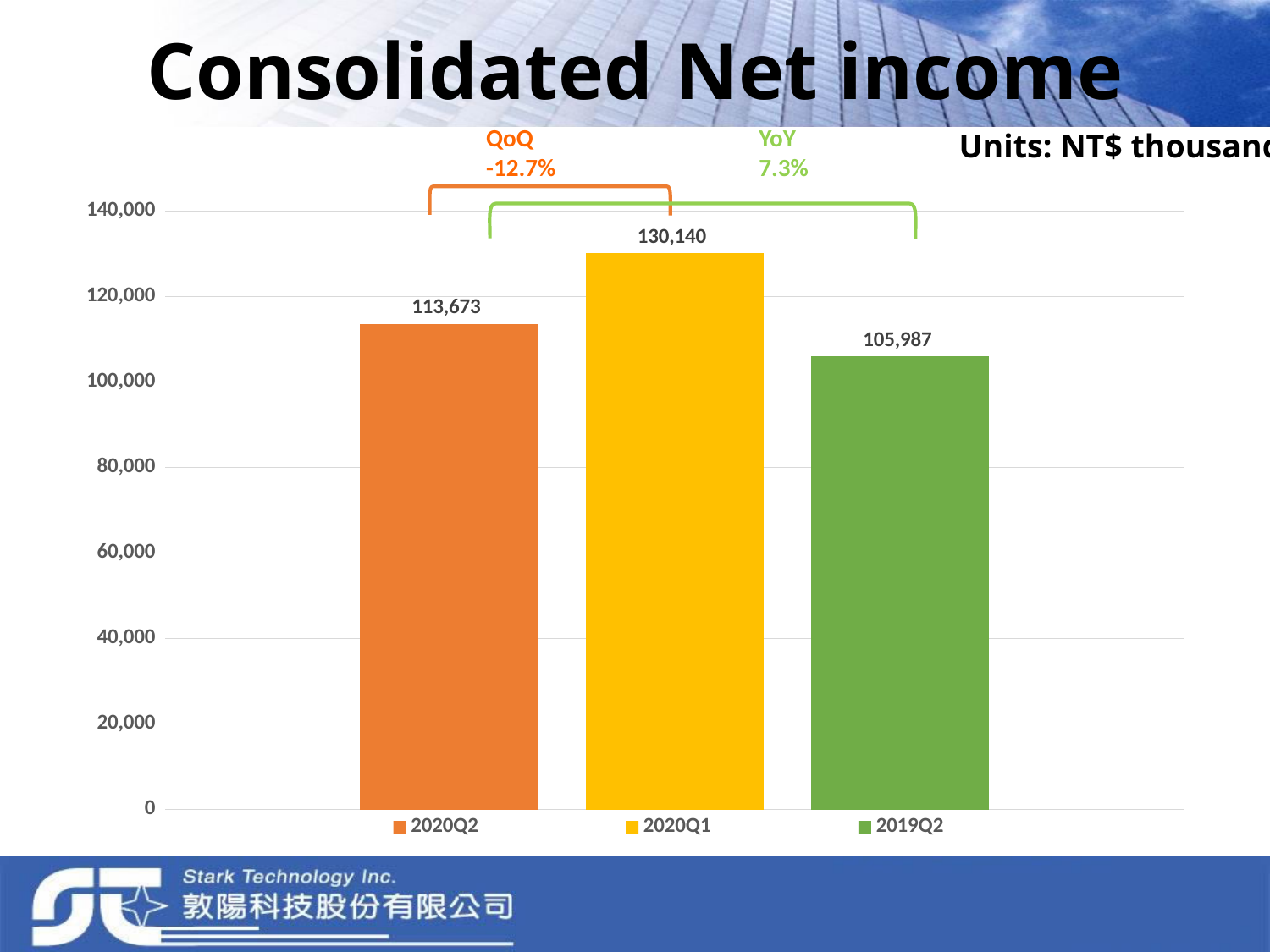
What is the consolidated net income for 2019Q2? 105,987 Which period has the highest consolidated net income? 2020Q1 What is the consolidated net income for 2020Q1? 130,140 What is the consolidated net income for 2020Q2? 113,673 Which period has the lowest consolidated net income? 2019Q2 Which is larger, the net income for 2020Q2 or 2019Q2? 2020Q2 What is the difference between the net income for 2020Q1 and 2020Q2? 16,467 How many bars are shown in the chart? 3 What QoQ percentage change is shown on the chart? -12.7% What kind of chart is shown on the slide? Bar chart Is the value for 2020Q1 greater or less than 120,000? greater What is the difference between the net income for 2020Q2 and 2019Q2? 7,686